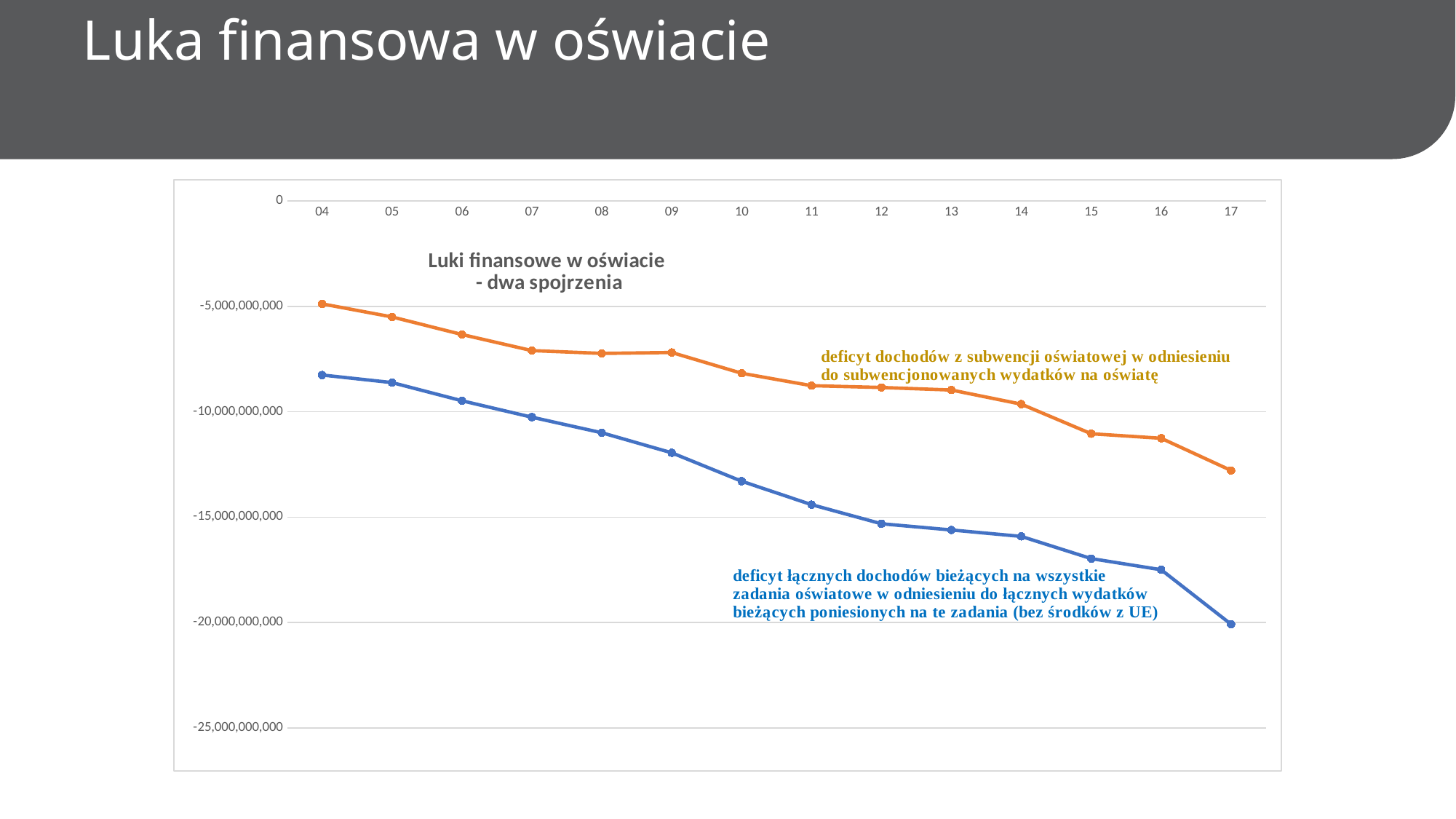
How many years (points) are plotted along the x axis? 14 Is the value of the blue series in year 04 greater or less than -10,000,000,000? greater Do the values of the blue series rise or fall from 04 to 17? fall What kind of chart is shown on the slide? line chart Which colour is the line for 'deficyt dochodów z subwencji oświatowej w odniesieniu do subwencjonowanych wydatków na oświatę'? orange Is the value of the orange series in year 17 greater or less than -10,000,000,000? less What is the title of the chart? Luki finansowe w oświacie - dwa spojrzenia Do the values of the orange series rise or fall from 04 to 17? fall In which year is the orange series at its highest value? 04 In which year is the blue series at its lowest value? 17 How many data series are plotted in the chart? 2 In year 17, which series has the larger (less negative) value, the orange or the blue? orange